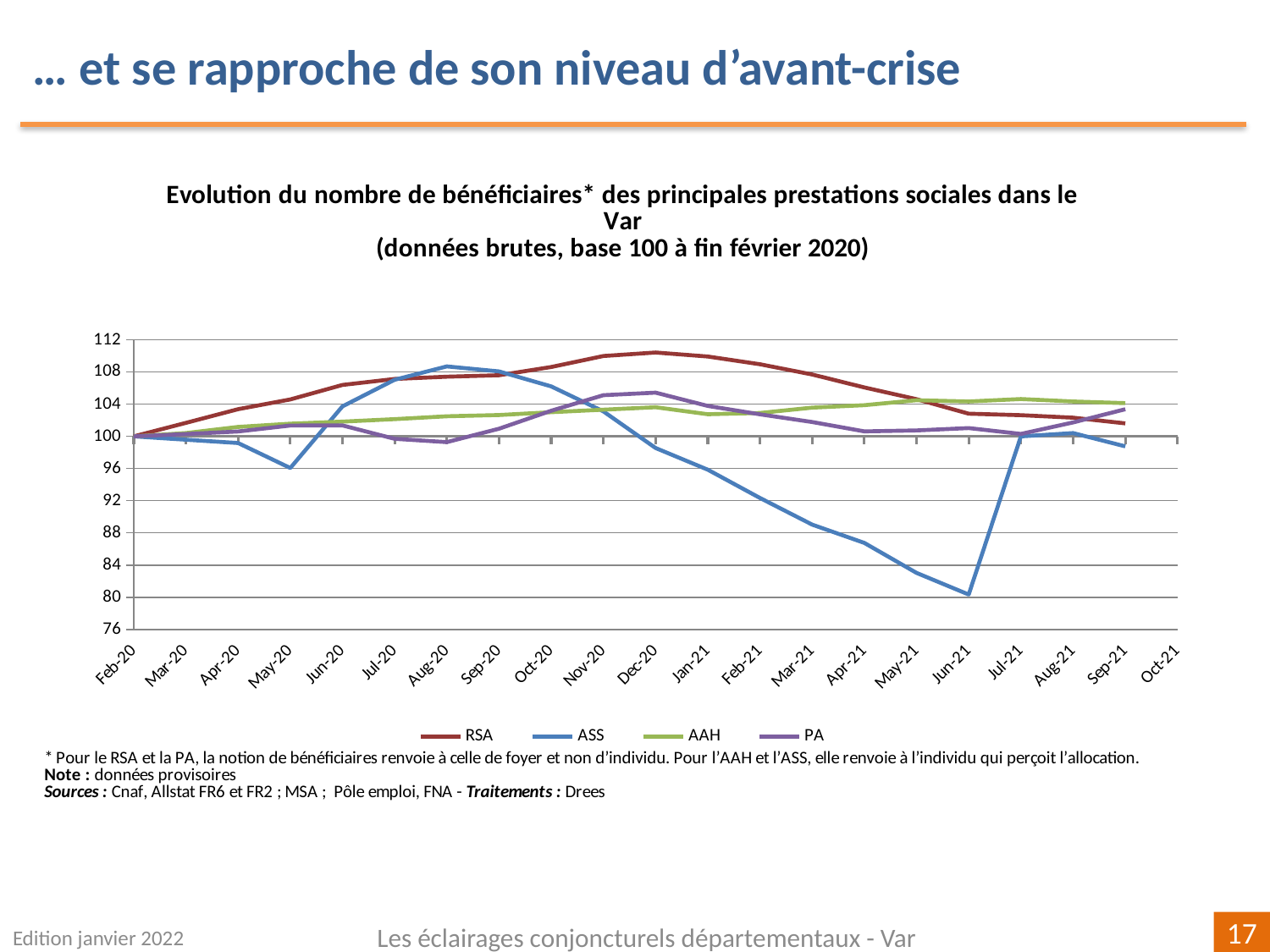
Is the value for ASS at Jun-21 greater or less than 84? less Does the ASS series rise or fall between Dec-20 and Jun-21? fall Is the value for RSA at Dec-20 greater or less than 108? greater How many series does the legend list? 4 What kind of chart is shown on the slide? line chart At Mar-21, which is larger, the value for RSA or the value for ASS? RSA Which series has the highest value at Dec-20? RSA Which series has the lowest value at Jun-21? ASS Which series are listed in the legend? RSA, ASS, AAH, PA What is the value of all four series at Feb-20? 100 How many month labels are shown on the x axis? 21 Is the value for PA at Dec-20 greater or less than 104? greater